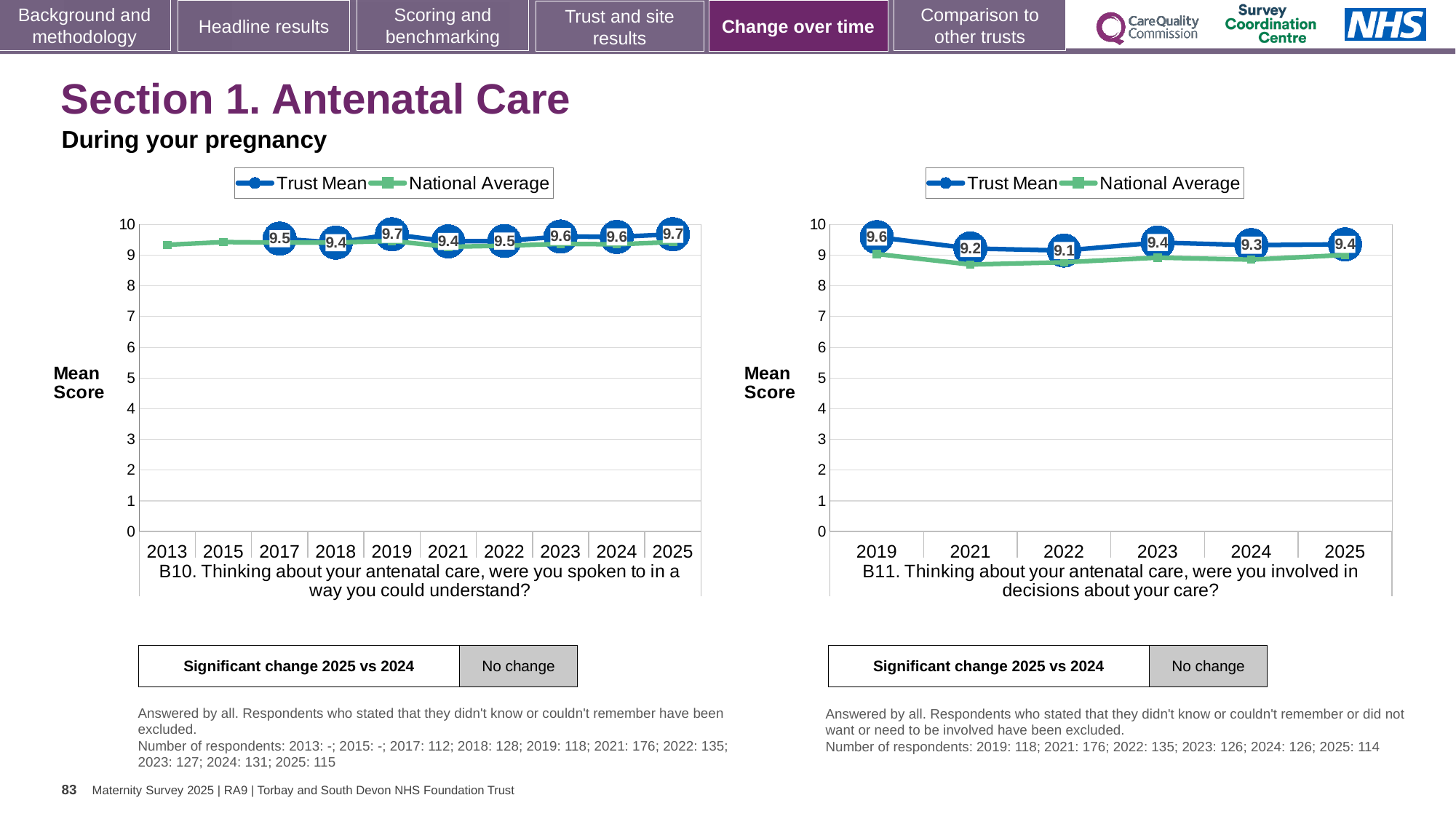
In the B11 chart on the right, which year has the highest Trust Mean? 2019 In the B11 chart on the right, which year has the lowest Trust Mean? 2022 In the B10 chart on the left, is the National Average for 2013 greater or less than 9? greater In the B11 chart on the right, is the Trust Mean higher in 2023 or in 2021? 2023 In the B11 chart on the right, what is the Trust Mean for 2022? 9.1 How many years are shown on the x axis of the B11 chart on the right? 6 In the B10 chart on the left, what is the difference between the Trust Mean in 2025 and in 2021? 0.3 What type of chart is the B11 chart on the right? Line chart In the B11 chart on the right, what is the difference between the Trust Mean in 2019 and in 2022? 0.5 How many series does the legend of the B10 chart on the left list? 2 In the B10 chart on the left, what is the Trust Mean for 2018? 9.4 In the B10 chart on the left, what is the Trust Mean for 2025? 9.7